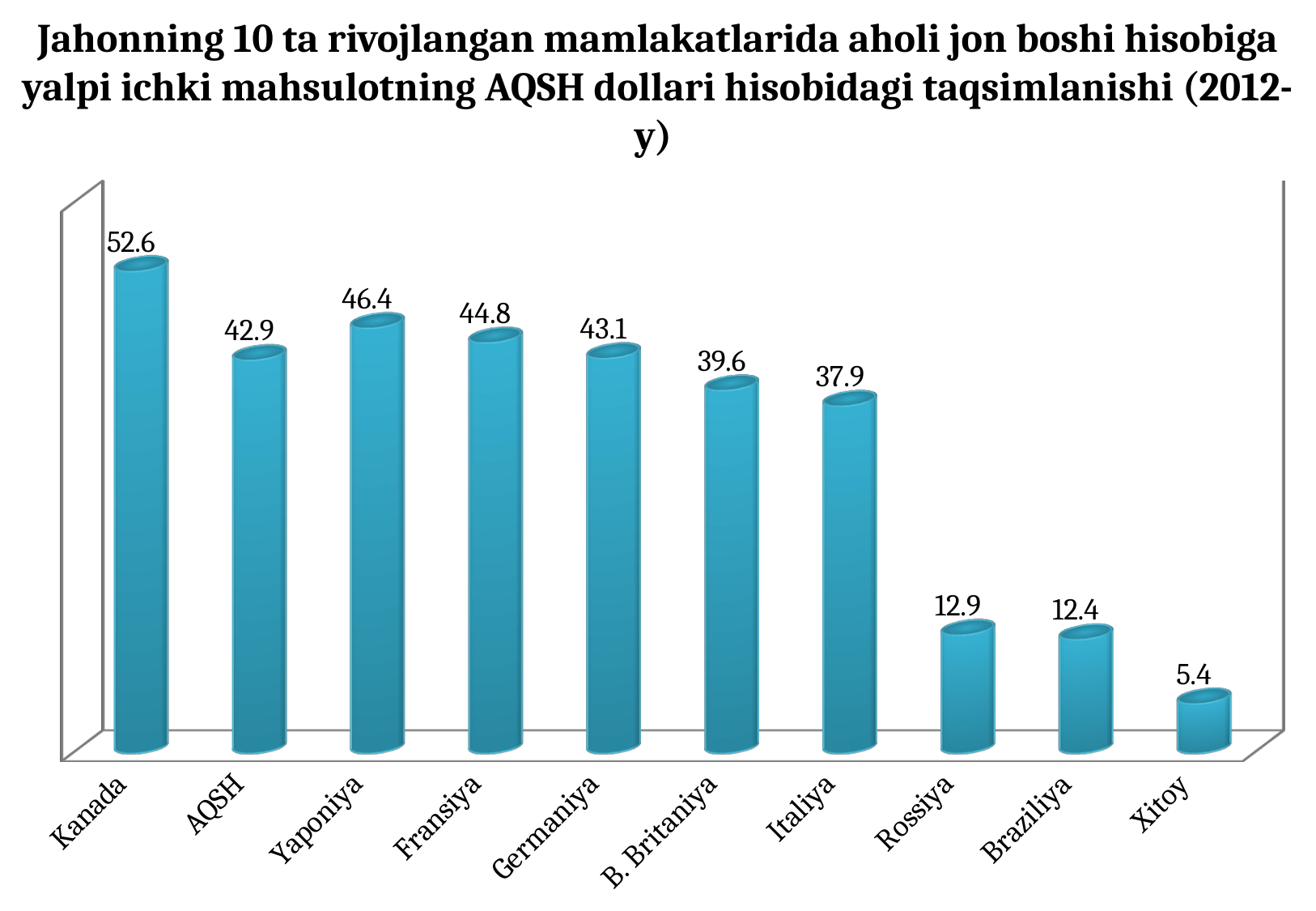
What year is given in the chart title? 2012 Which is larger, the value for Fransiya or the value for Germaniya? Fransiya Which country has the highest value? Kanada What kind of chart is this? Bar chart What is the difference between the values for Kanada and AQSH? 9.7 What is the value for Xitoy? 5.4 What is the value for Kanada? 52.6 What is the difference between the values for Rossiya and Braziliya? 0.5 Which country has the lowest value? Xitoy What is the value for B. Britaniya? 39.6 What is the value for Yaponiya? 46.4 How many countries are shown in the chart? 10